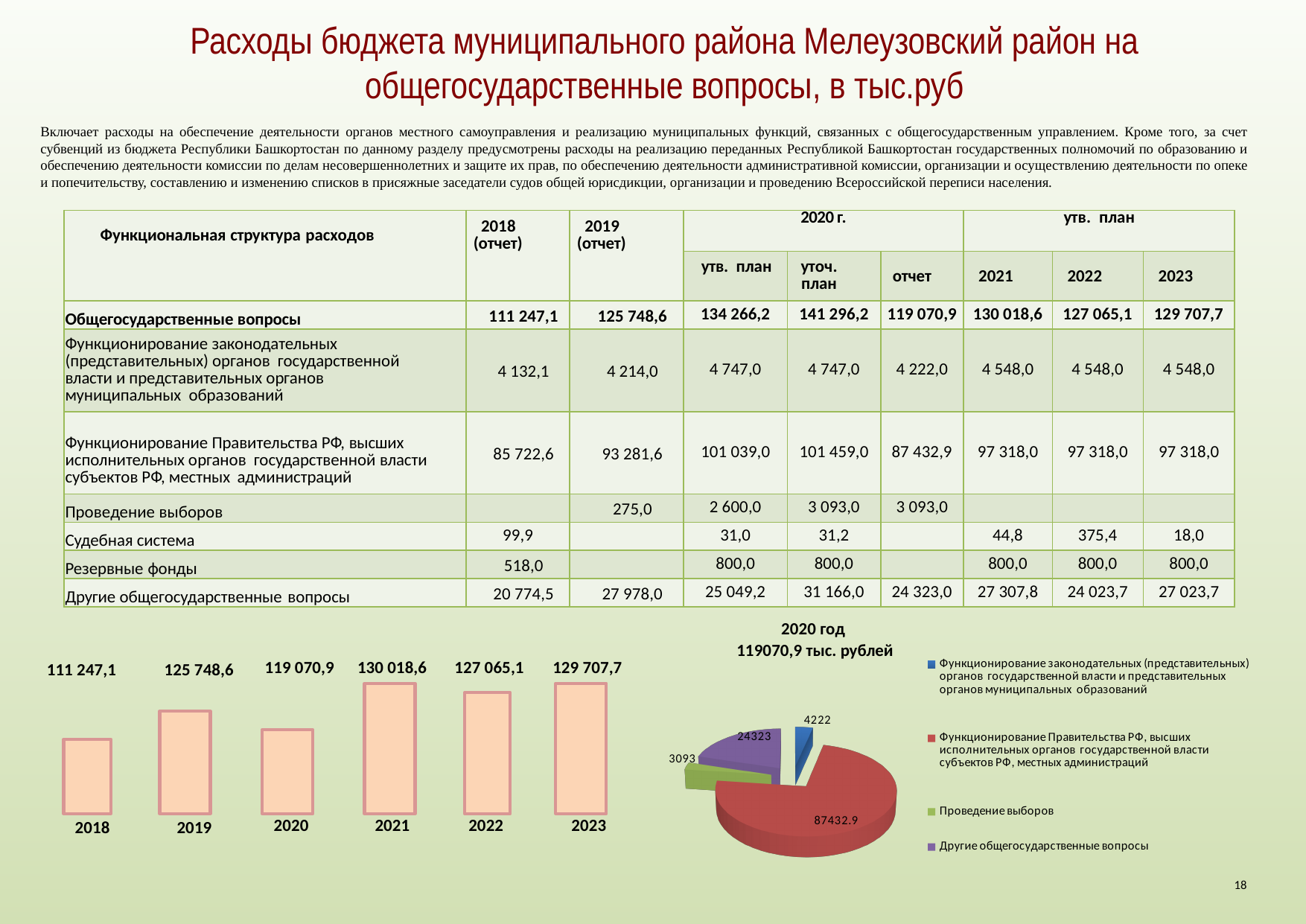
On the bar chart at the bottom left, which is larger: the value for 2019 or the value for 2020? 2019 What kind of chart is shown at the bottom left of the slide? bar chart On the bar chart at the bottom left, which year has the highest value? 2021 On the pie chart titled '2020 год', which category has the largest slice? Функционирование Правительства РФ, высших исполнительных органов государственной власти субъектов РФ, местных администраций On the bar chart at the bottom left, what is the value for 2023? 129 707,7 On the pie chart titled '2020 год', what is the value of the slice for 'Проведение выборов'? 3093 On the bar chart at the bottom left, what is the value for 2020? 119 070,9 How many bars are shown on the bar chart at the bottom left? 6 On the bar chart at the bottom left, what is the difference between the values for 2019 and 2018? 14 501,5 How many slices does the pie chart titled '2020 год' have? 4 On the bar chart at the bottom left, which year has the lowest value? 2018 What total amount is stated in the title of the pie chart titled '2020 год'? 119070,9 тыс. рублей